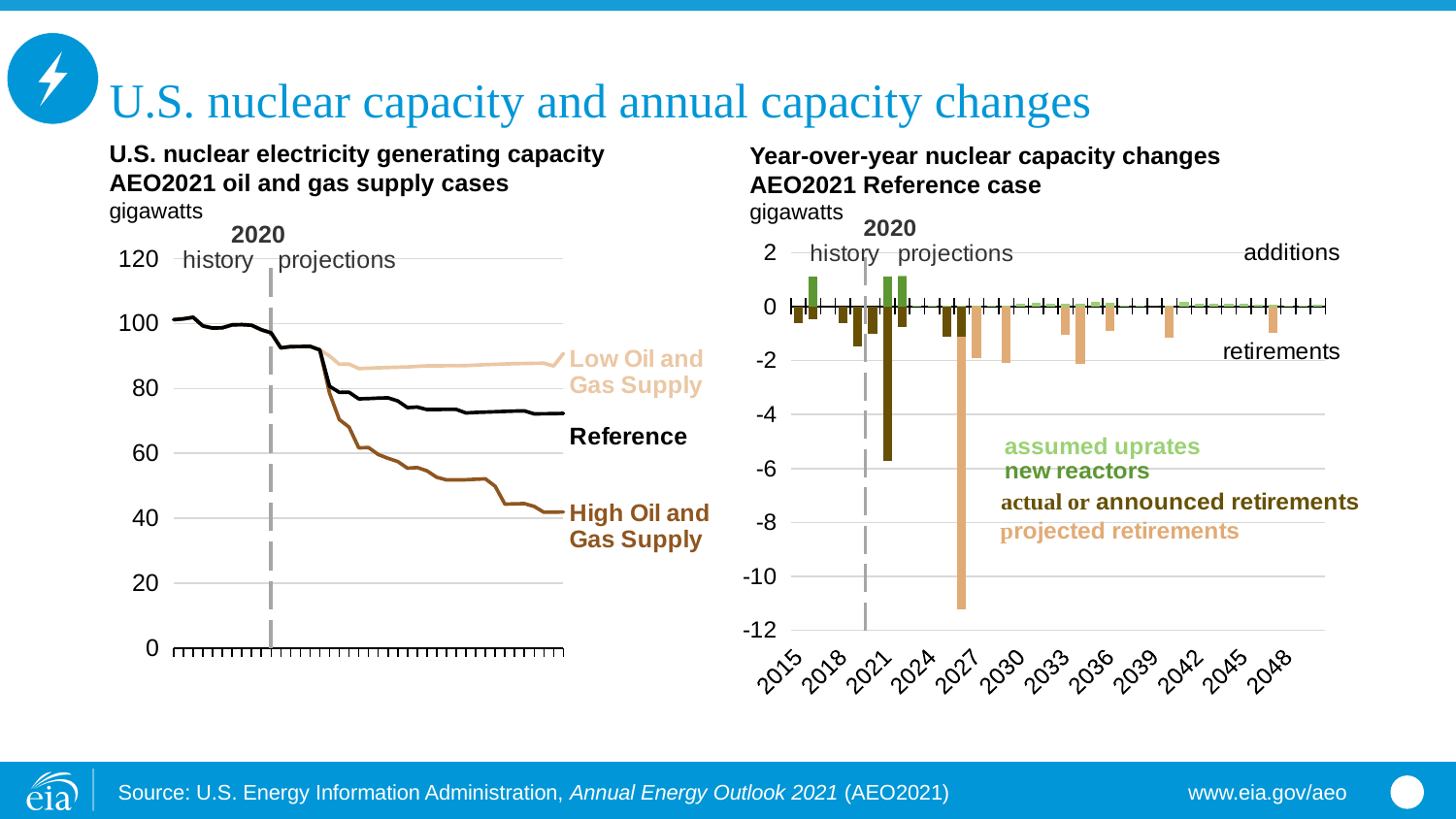
In the left chart, 'U.S. nuclear electricity generating capacity', does the Reference series rise or fall over the projection period? fall In the left chart, 'U.S. nuclear electricity generating capacity', is the value for Low Oil and Gas Supply at the end of the projection greater or less than 80? greater How many series does the legend of the right chart, 'Year-over-year nuclear capacity changes', list? 4 What kind of chart is the right chart, 'Year-over-year nuclear capacity changes'? bar chart In the left chart, 'U.S. nuclear electricity generating capacity', is the value for High Oil and Gas Supply at the end of the projection greater or less than 60? less In the left chart, 'U.S. nuclear electricity generating capacity', which is larger at the end of the projection: Reference or High Oil and Gas Supply? Reference What kind of chart is the left chart, 'U.S. nuclear electricity generating capacity'? line chart In the right chart, 'Year-over-year nuclear capacity changes', what year does the dashed vertical line separating history from projections mark? 2020 In the left chart, 'U.S. nuclear electricity generating capacity', which series is lowest at the end of the projection period? High Oil and Gas Supply How many series are plotted in the left chart, 'U.S. nuclear electricity generating capacity'? 3 In the left chart, 'U.S. nuclear electricity generating capacity', which series is highest at the end of the projection period? Low Oil and Gas Supply